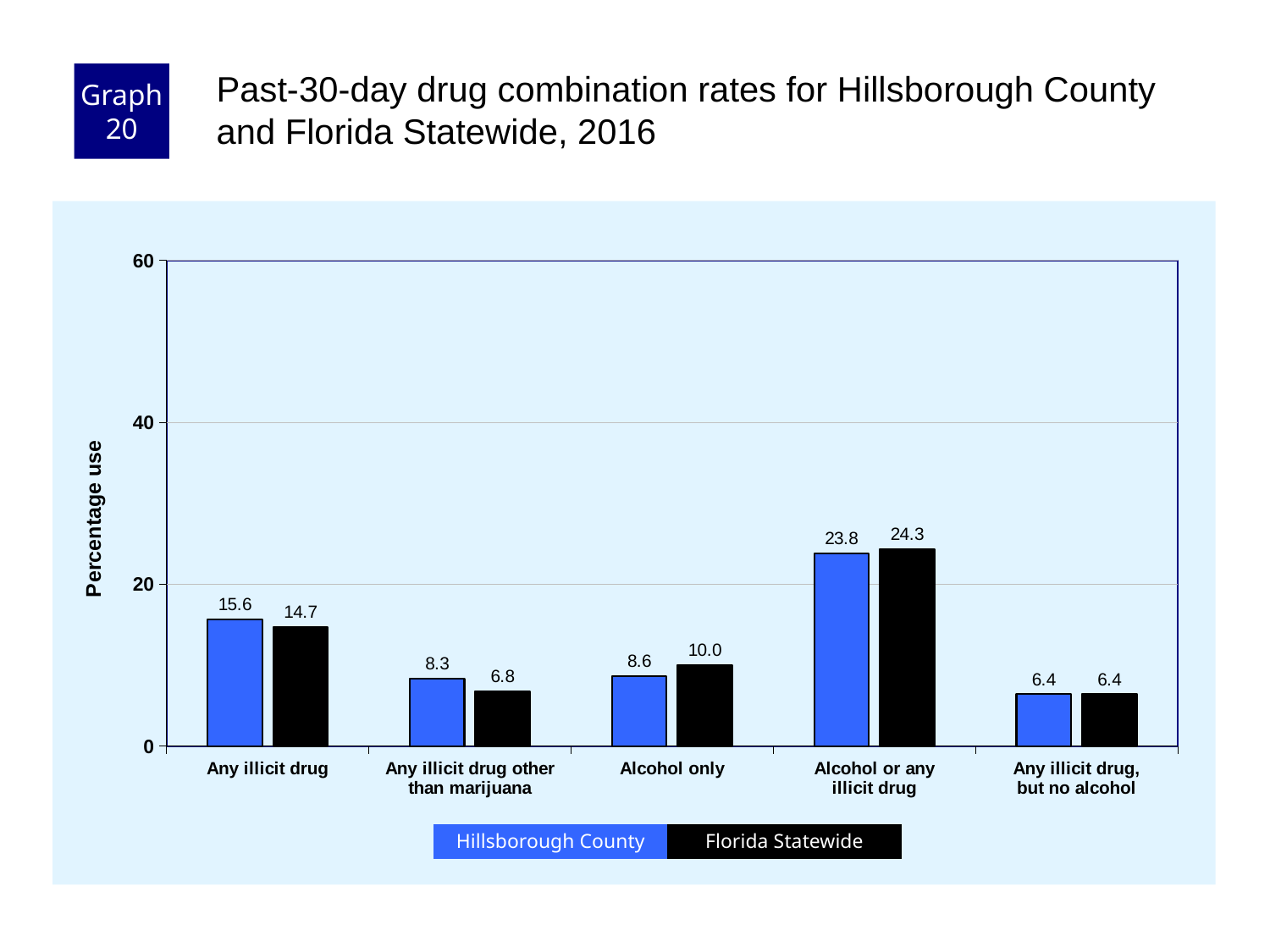
Is the Florida Statewide value for Alcohol or any illicit drug greater or less than 20? greater How many series does the legend list? 2 What is the difference between the Florida Statewide and Hillsborough County values for Alcohol or any illicit drug? 0.5 What is the Hillsborough County value for Any illicit drug? 15.6 How many categories are shown on the x axis? 5 Which category has the highest Hillsborough County value? Alcohol or any illicit drug What is the Florida Statewide value for Any illicit drug other than marijuana? 6.8 Which category has the lowest Florida Statewide value? Any illicit drug, but no alcohol For Any illicit drug other than marijuana, which is larger: Hillsborough County or Florida Statewide? Hillsborough County What is the Florida Statewide value for Alcohol only? 10.0 What kind of chart is shown? bar chart What is the label of the y axis? Percentage use